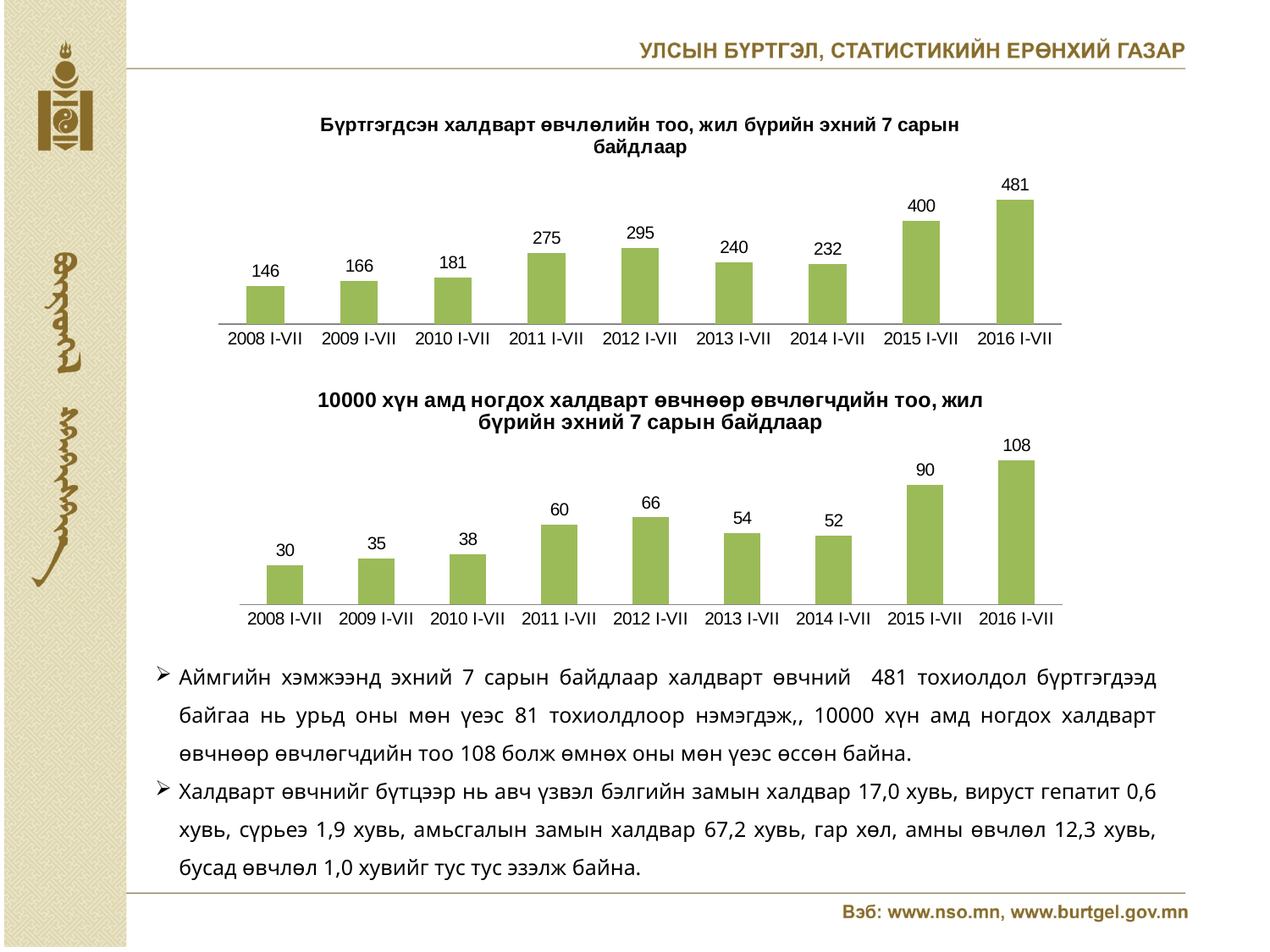
In the top chart (Бүртгэгдсэн халдварт өвчлөлийн тоо), what is the value for 2010 I-VII? 181 In the top chart (Бүртгэгдсэн халдварт өвчлөлийн тоо), how many bars are plotted? 9 In the bottom chart (10000 хүн амд ногдох халдварт өвчнөөр өвчлөгчдийн тоо), what is the value for 2011 I-VII? 60 In the top chart (Бүртгэгдсэн халдварт өвчлөлийн тоо), which is larger, the value for 2012 I-VII or 2013 I-VII? 2012 I-VII What type of chart is the top chart (Бүртгэгдсэн халдварт өвчлөлийн тоо)? Bar chart In the top chart (Бүртгэгдсэн халдварт өвчлөлийн тоо), which year has the lowest value? 2008 I-VII In the bottom chart (10000 хүн амд ногдох халдварт өвчнөөр өвчлөгчдийн тоо), what is the difference between the values for 2016 I-VII and 2008 I-VII? 78 In the top chart (Бүртгэгдсэн халдварт өвчлөлийн тоо), what is the value for 2016 I-VII? 481 In the bottom chart (10000 хүн амд ногдох халдварт өвчнөөр өвчлөгчдийн тоо), which year has the highest value? 2016 I-VII In the top chart (Бүртгэгдсэн халдварт өвчлөлийн тоо), what is the difference between the values for 2016 I-VII and 2015 I-VII? 81 In the bottom chart (10000 хүн амд ногдох халдварт өвчнөөр өвчлөгчдийн тоо), do the values rise or fall from 2014 I-VII to 2016 I-VII? Rise In the bottom chart (10000 хүн амд ногдох халдварт өвчнөөр өвчлөгчдийн тоо), which is larger, the value for 2013 I-VII or 2014 I-VII? 2013 I-VII